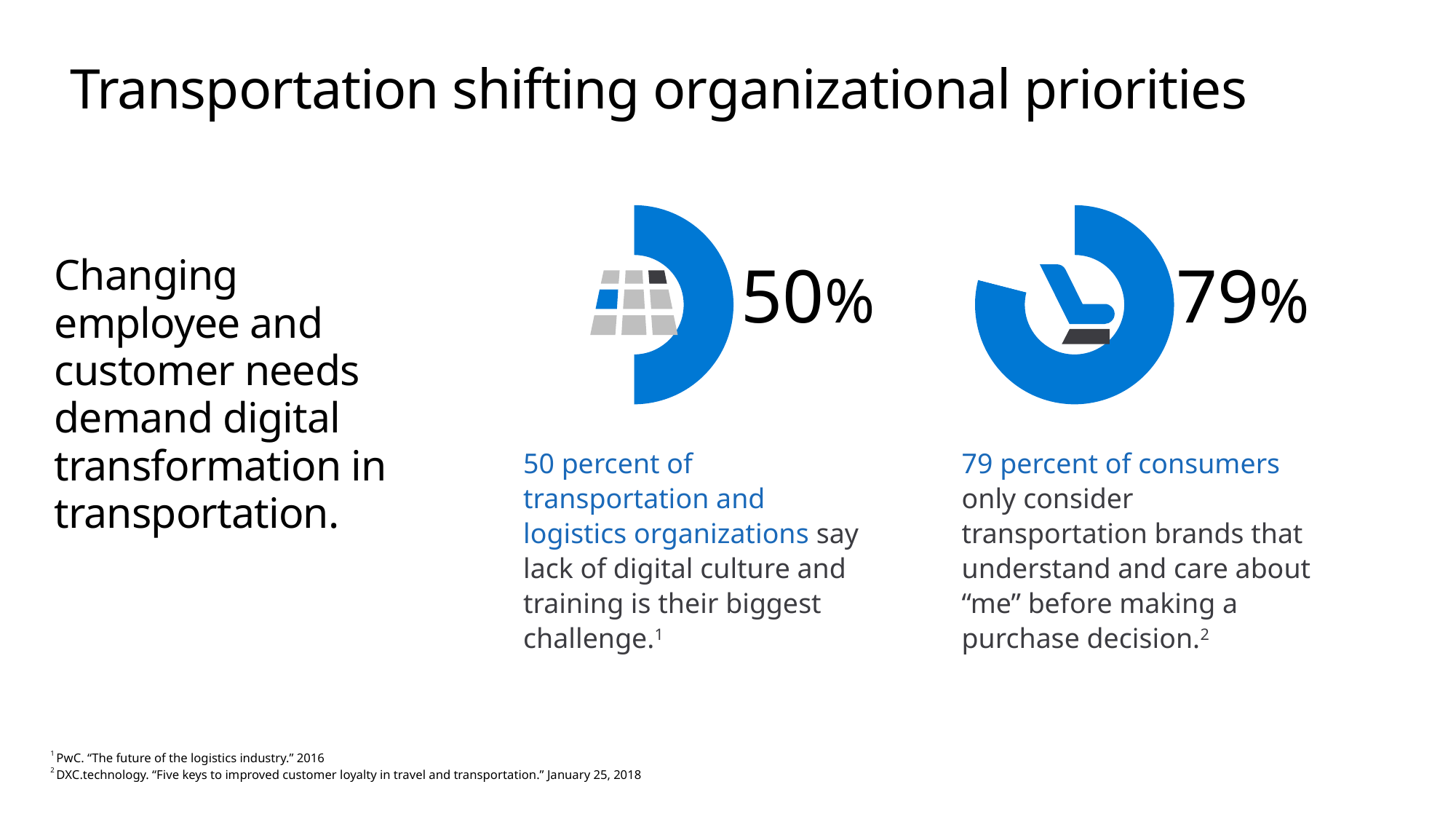
What value is shown on the left donut chart? 50% Is the value on the right donut chart greater or less than 75%? greater What is the difference between the value on the right donut chart and the value on the left donut chart? 29 percentage points How many donut charts are on the slide? 2 What is the title of the slide containing the two donut charts? Transportation shifting organizational priorities What percentage of consumers only consider transportation brands that understand and care about them, according to the right donut chart? 79% Which is larger, the value on the left donut chart or the value on the right donut chart? The right donut chart (79%) What percentage of transportation and logistics organizations say lack of digital culture and training is their biggest challenge, according to the left donut chart? 50% What value is shown on the right donut chart? 79% What colour is the filled portion of the donut charts? Blue What kind of chart is used to show the 50% and 79% figures? Donut chart What share of the left donut ring is filled in blue? 50%